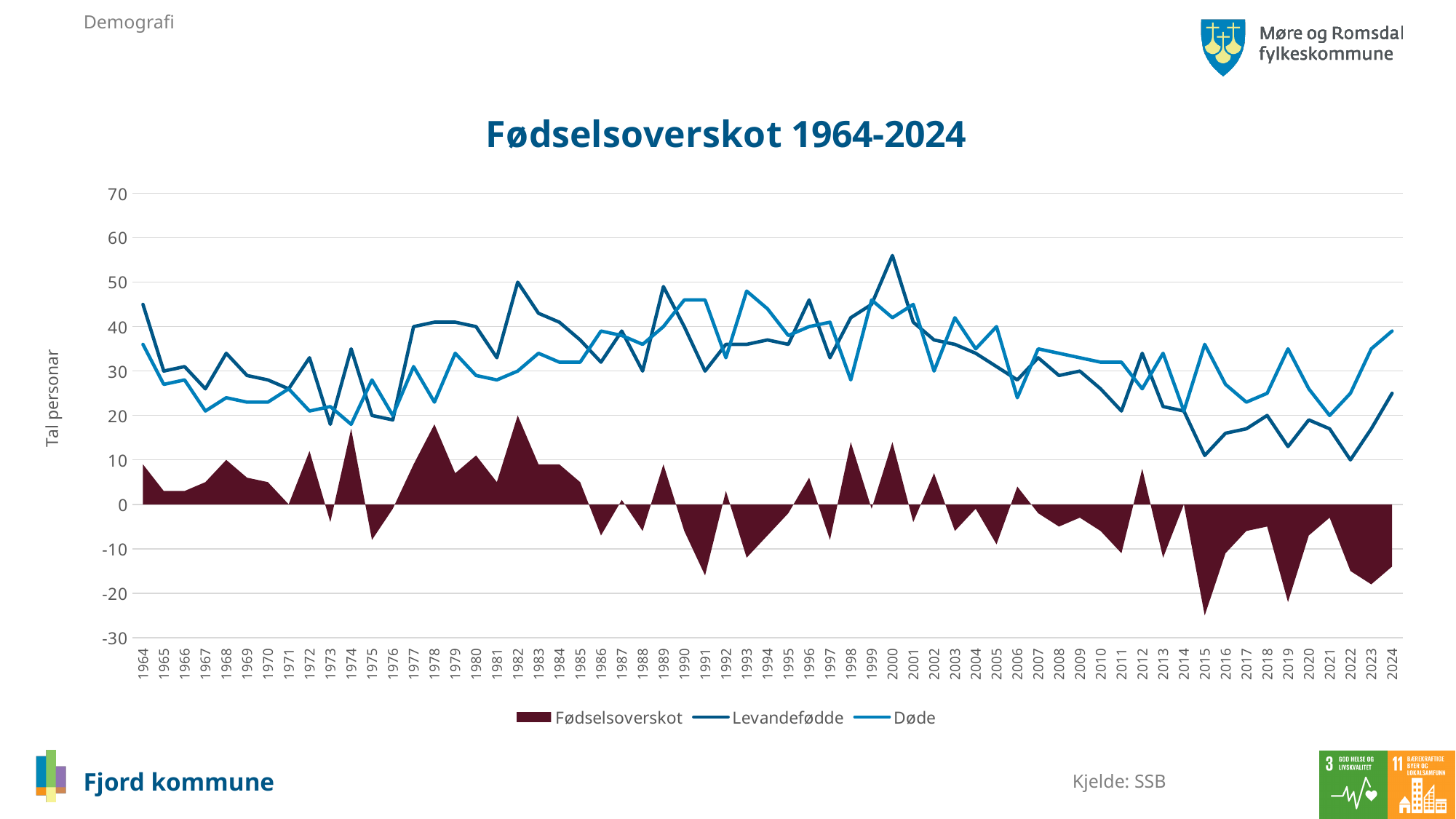
In which year does the Levandefødde series reach its highest value? 2000 Is the value for Fødselsoverskot in 1982 greater or less than 10? greater Does the Levandefødde series generally rise or fall between 2000 and 2022? fall Is the value for Levandefødde in 2022 greater or less than 20? less Is the value for Døde in 1964 greater or less than 30? greater How many years are shown along the x axis of the chart? 61 How many series does the chart legend list? 3 What is the label on the vertical axis of the chart? Tal personar In 2024, which is larger: Levandefødde or Døde? Døde What is the title of the chart? Fødselsoverskot 1964-2024